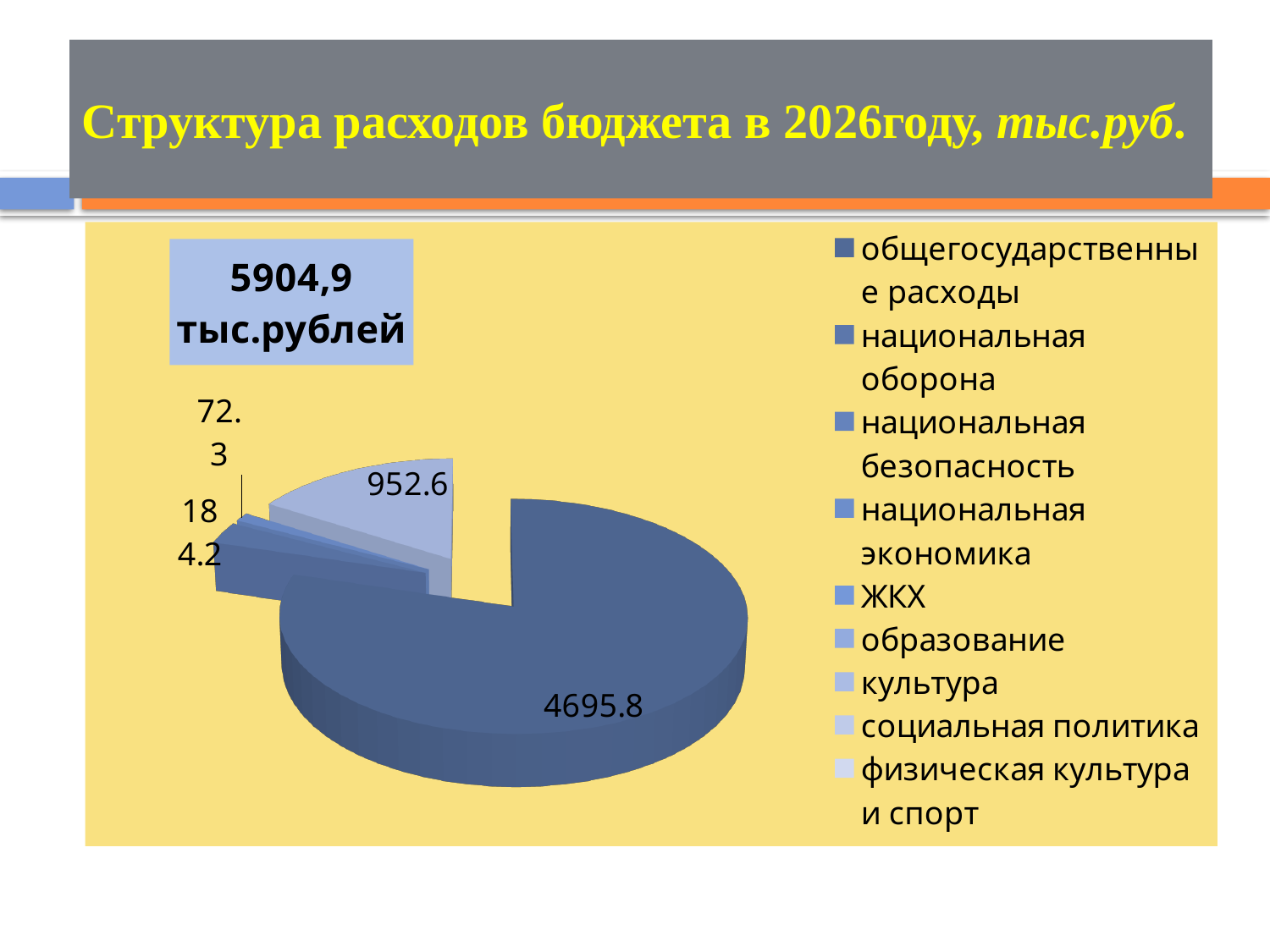
What is the value of the largest slice of the pie chart? 4695.8 What total amount is shown in the box above the pie chart? 5904,9 тыс.рублей Which legend category does the largest slice of the pie chart belong to? общегосударственные расходы How many entries does the legend of the pie chart list? 9 What is the smallest value printed as a data label on the pie chart? 72.3 What is the value shown for общегосударственные расходы? 4695.8 Which is larger: the slice labelled 952.6 or the slice labelled 72.3? 952.6 How many data labels are printed on the pie chart? 4 What kind of chart is shown on the slide? pie chart What is the title of the chart on the slide? 5904,9 тыс.рублей What is the difference between the slice labelled 4695.8 and the slice labelled 952.6? 3743.2